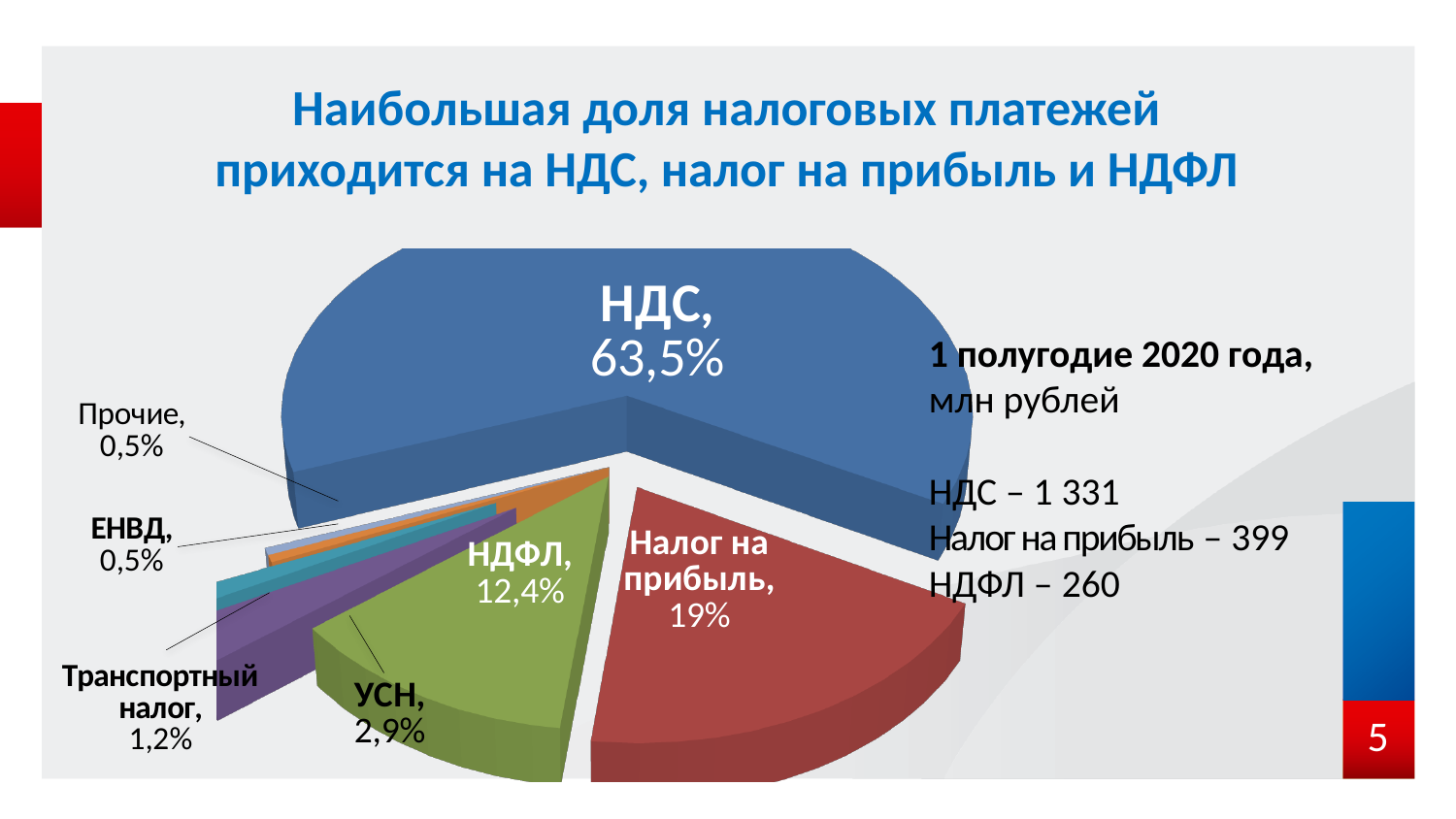
What is the difference in percentage points between НДС and Налог на прибыль? 44,5 What is the difference in percentage points between Налог на прибыль and НДФЛ? 6,6 What share of tax payments does НДС account for? 63,5% What period and unit does the text next to the chart state the data is for? 1 полугодие 2020 года, млн рублей What is the share for УСН? 2,9% Which category has the largest slice of the pie? НДС What is the share for Транспортный налог? 1,2% What type of chart is shown on the slide? pie chart Which is larger, the share for НДФЛ or the share for УСН? НДФЛ How many slices does the pie chart have? 7 What is the share for Налог на прибыль? 19% What is the share for НДФЛ? 12,4%